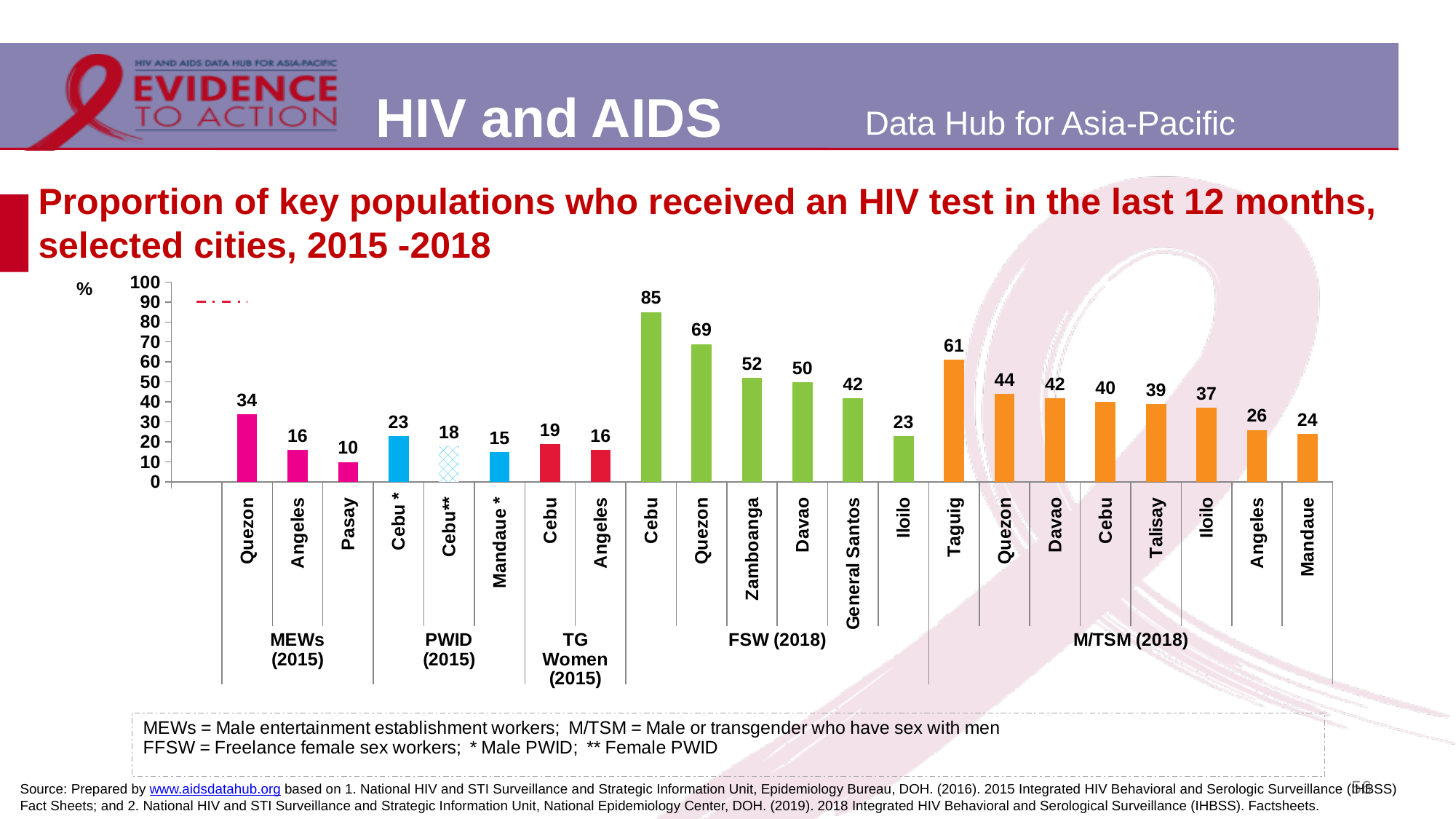
What unit is shown on the y axis of the chart? % Which is larger: Quezon in the MEWs (2015) group or Quezon in the M/TSM (2018) group? Quezon in M/TSM (2018) What is the value for Mandaue * in the PWID (2015) group? 15 What is the value for Taguig in the M/TSM (2018) group? 61 How many bars are plotted in the chart? 22 What is the value for Cebu in the FSW (2018) group? 85 Which city has the lowest value in the M/TSM (2018) group? Mandaue How many cities are shown in the FSW (2018) group? 6 What is the value for Pasay in the MEWs (2015) group? 10 What is the difference between Cebu and Quezon in the FSW (2018) group? 16 What kind of chart is shown on the slide? Bar chart Which city has the highest value across the whole chart? Cebu (FSW 2018)